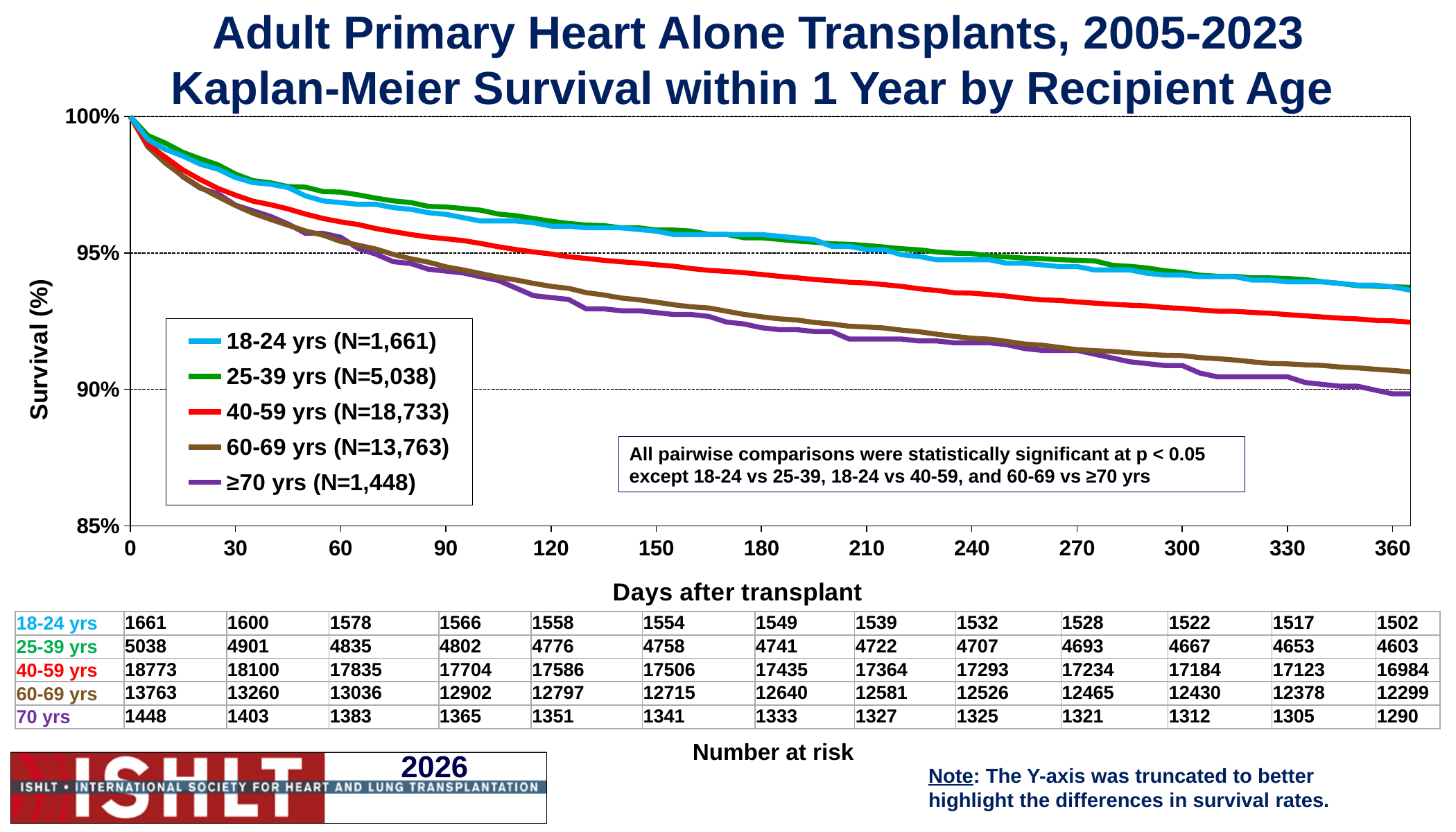
Is the survival for ≥70 yrs at 180 days greater or less than 95%? less In the number at risk table, how many 40-59 yrs patients are at risk at 360 days? 16984 Is the survival for 18-24 yrs at 360 days greater or less than 95%? less According to the legend, what is the N for the 40-59 yrs group? N=18,733 Is the survival for 40-59 yrs at 360 days greater or less than 90%? greater At 360 days after transplant, which group has higher survival: 40-59 yrs or ≥70 yrs? 40-59 yrs What kind of chart is shown on the slide? Line chart In the number at risk table, how many 70 yrs patients are at risk at 180 days? 1333 Do the survival curves rise or fall as days after transplant increase? Fall How many series does the legend list? 5 What is the title of the chart? Adult Primary Heart Alone Transplants, 2005-2023 Kaplan-Meier Survival within 1 Year by Recipient Age Which recipient age group has the lowest survival at 360 days after transplant? ≥70 yrs